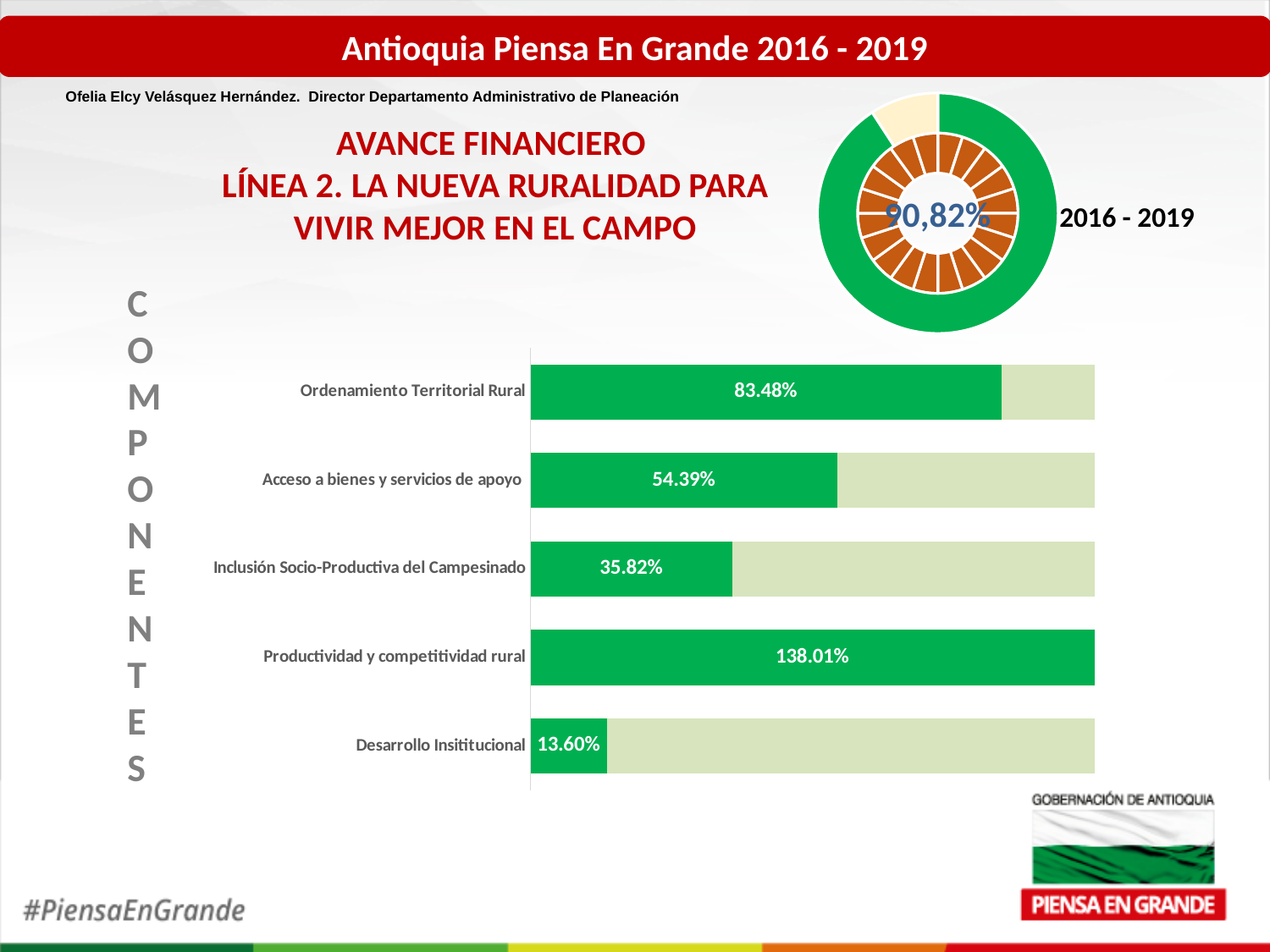
In the bar chart, which is larger: the value for Inclusión Socio-Productiva del Campesinado or the value for Desarrollo Insititucional? Inclusión Socio-Productiva del Campesinado In the bar chart, what is the value for Desarrollo Insititucional? 13.60% In the bar chart, what is the value for Productividad y competitividad rural? 138.01% In the bar chart, what is the difference between the values for Ordenamiento Territorial Rural and Acceso a bienes y servicios de apoyo? 29.09% In the bar chart, which component has the lowest value? Desarrollo Insititucional In the bar chart, what is the value for Ordenamiento Territorial Rural? 83.48% What kind of chart is the chart listing the components? Bar chart What percentage is shown in the centre of the donut chart at the top right of the slide? 90,82% In the bar chart, what is the value for Acceso a bienes y servicios de apoyo? 54.39% In the bar chart, what is the value for Inclusión Socio-Productiva del Campesinado? 35.82% How many components are shown in the bar chart? 5 In the bar chart, which component has the highest value? Productividad y competitividad rural